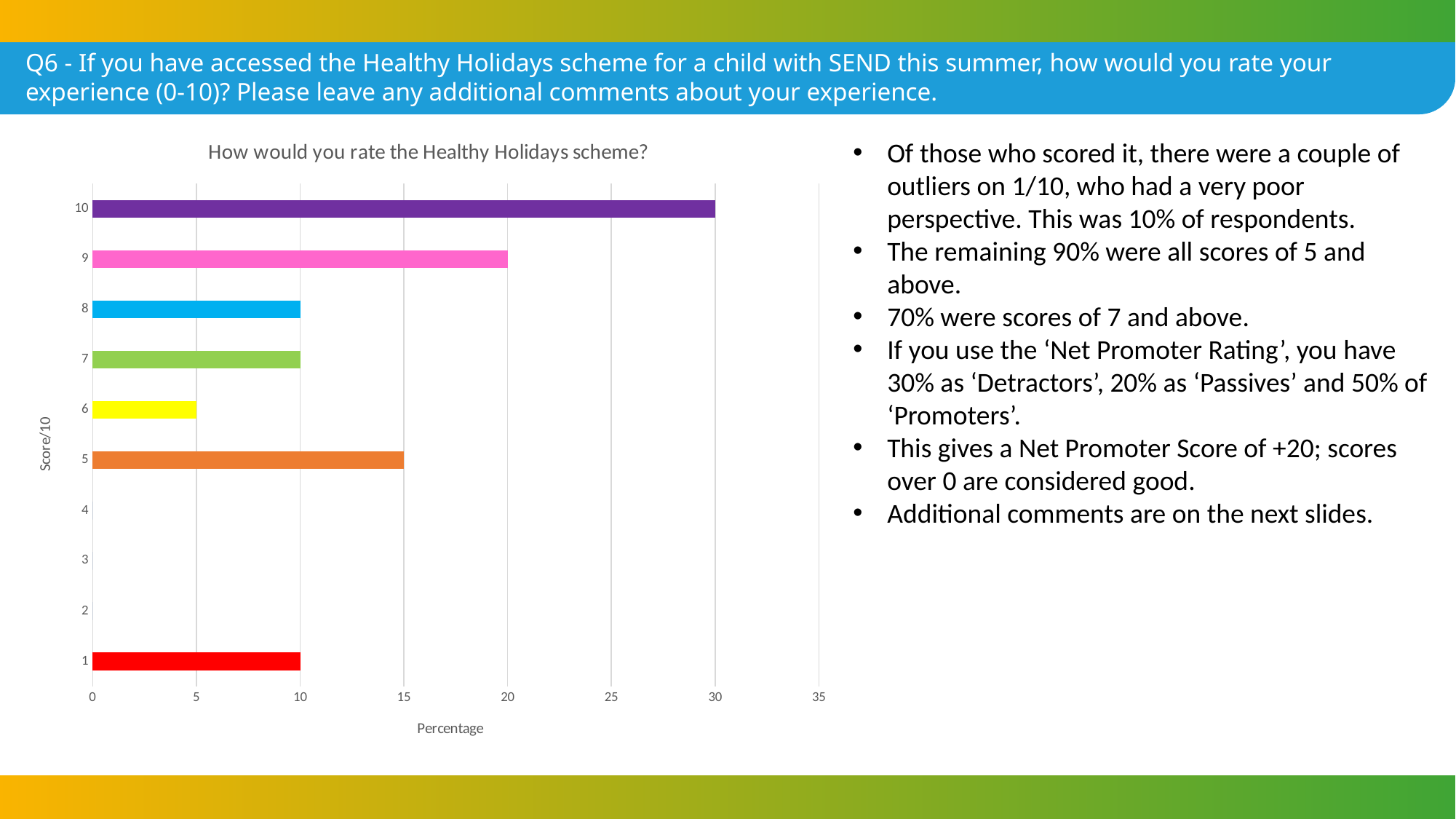
Which score has the highest percentage? 10 What is the difference in percentage between a score of 10 and a score of 9? 10 What is the percentage for a score of 9? 20 What is the label of the horizontal axis? Percentage What is the percentage for a score of 10? 30 What is the title of the chart? How would you rate the Healthy Holidays scheme? What is the percentage for a score of 6? 5 How many score categories are shown on the vertical axis? 10 Which has a larger percentage, a score of 5 or a score of 8? 5 Is the value for a score of 10 greater or less than 25? greater What is the percentage for a score of 5? 15 What type of chart is shown on the slide? Bar chart